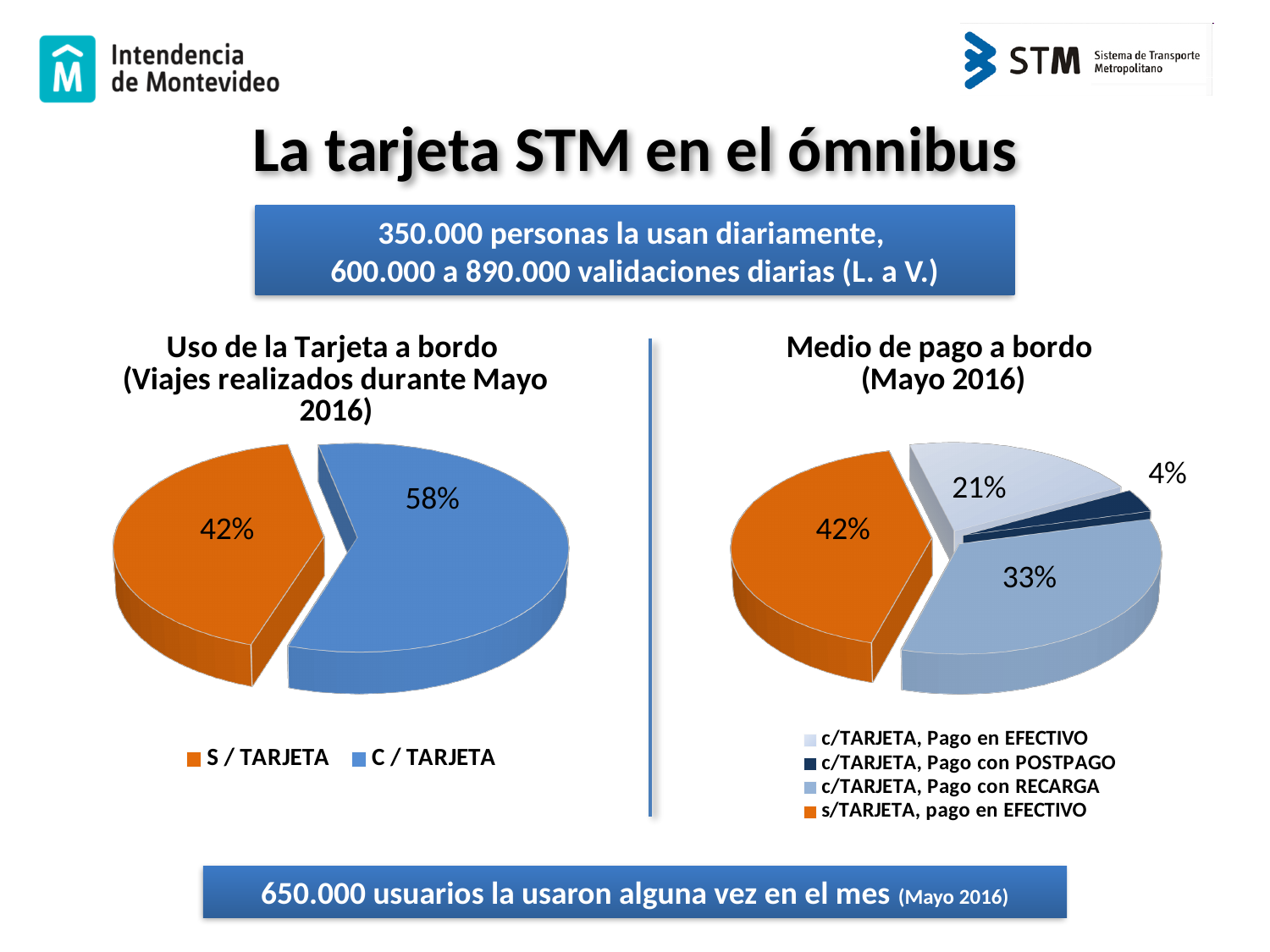
In the 'Medio de pago a bordo' chart, which category has the largest share? s/TARJETA, pago en EFECTIVO How many categories does the legend of the 'Medio de pago a bordo' chart list? 4 In the 'Medio de pago a bordo' chart, what share is 'c/TARJETA, Pago con POSTPAGO'? 4% In the 'Uso de la Tarjeta a bordo' chart, what share of trips is C / TARJETA? 58% In the 'Medio de pago a bordo' chart, what share is 'c/TARJETA, Pago con RECARGA'? 33% In the 'Uso de la Tarjeta a bordo' chart, what share of trips is S / TARJETA? 42% In the 'Medio de pago a bordo' chart, which is larger: 'c/TARJETA, Pago con RECARGA' or 'c/TARJETA, Pago en EFECTIVO'? c/TARJETA, Pago con RECARGA What kind of chart is 'Uso de la Tarjeta a bordo'? Pie chart In the 'Uso de la Tarjeta a bordo' chart, which category has the larger share? C / TARJETA In the 'Medio de pago a bordo' chart, what share is 'c/TARJETA, Pago en EFECTIVO'? 21% In the 'Medio de pago a bordo' chart, which category has the smallest share? c/TARJETA, Pago con POSTPAGO In the 'Uso de la Tarjeta a bordo' chart, what is the difference in percentage points between C / TARJETA and S / TARJETA? 16 percentage points